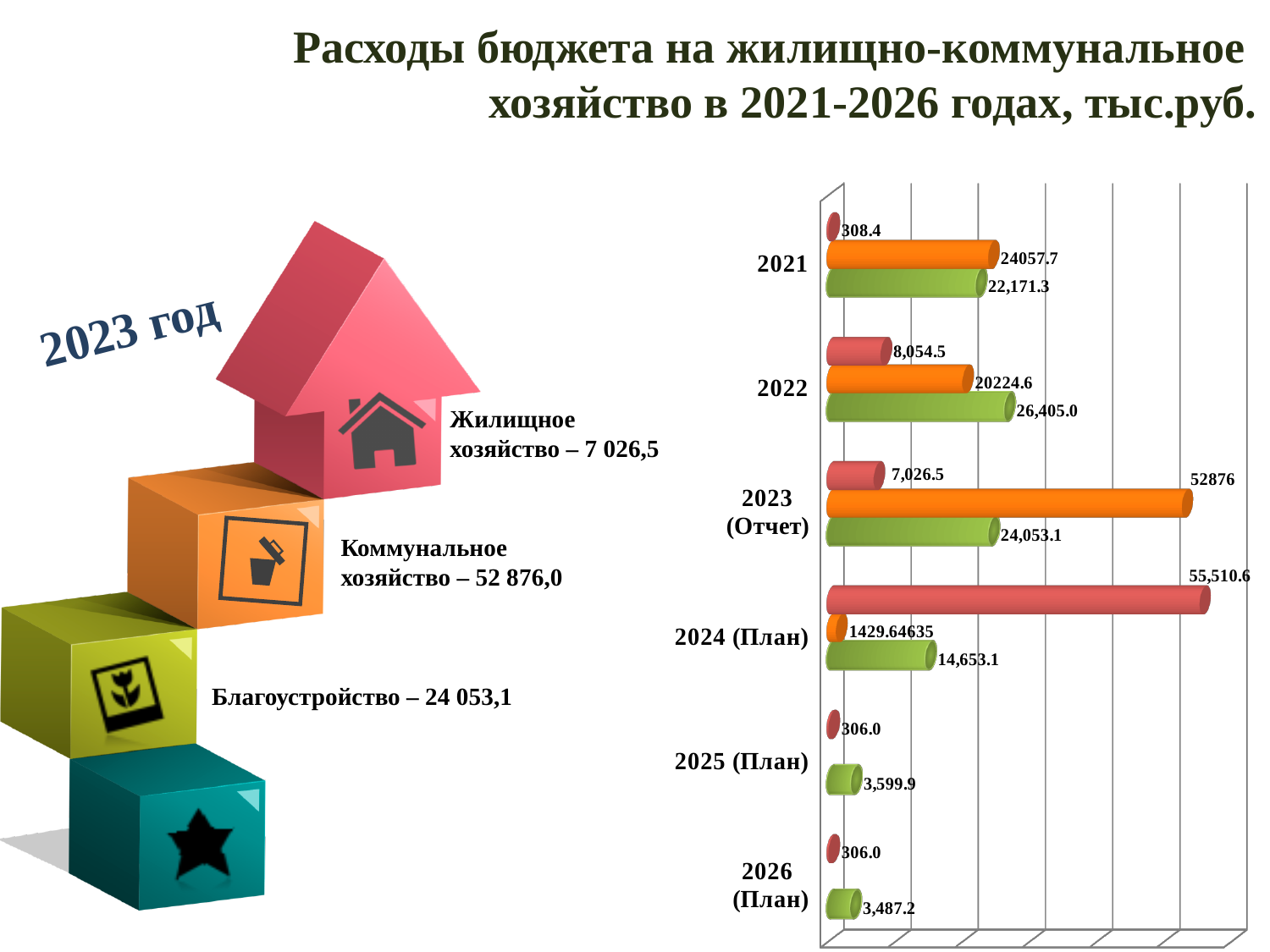
What is the value of the orange bar for 2023 (Отчет)? 52876 Which year has the shortest green bar? 2026 (План) What is the title of the chart on the slide? Расходы бюджета на жилищно-коммунальное хозяйство в 2021-2026 годах, тыс.руб. What is the value of the green bar for 2022? 26,405.0 Which year has the longest red bar? 2024 (План) What is the value of the green bar for 2026 (План)? 3,487.2 What is the value of the red bar for 2021? 308.4 What is the value of the red bar for 2024 (План)? 55,510.6 How many year categories are shown on the chart? 6 Which is larger for 2022: the orange bar or the green bar? the green bar What type of chart is shown on the slide? bar chart What is the difference between the green bar values for 2025 (План) and 2026 (План)? 112.7